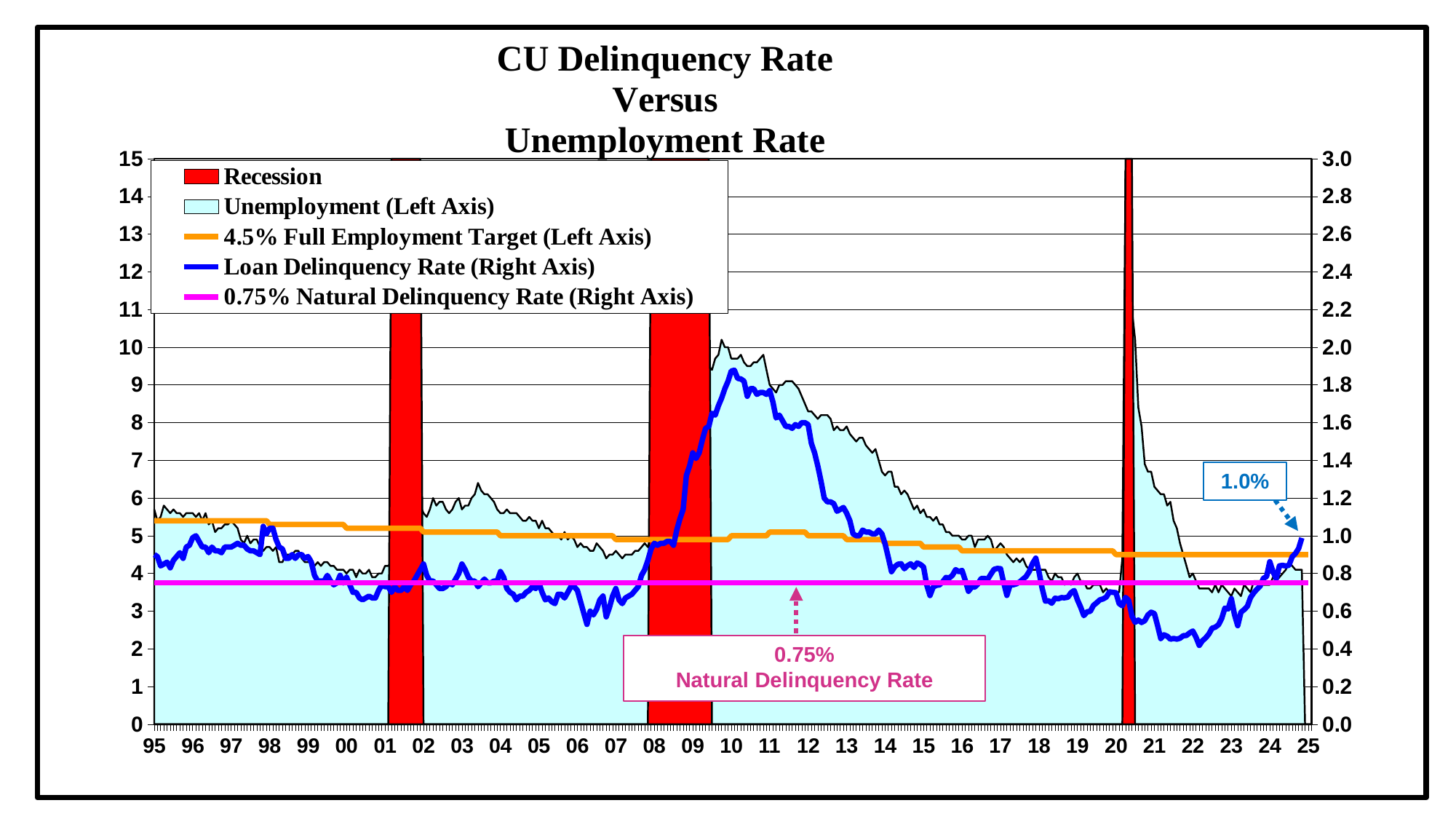
What is the Natural Delinquency Rate shown by the magenta line? 0.75% What value is labelled for the Loan Delinquency Rate at the end of the series in 2025? 1.0% In which year does the unemployment rate reach its highest point? 2020 Does the Loan Delinquency Rate rise or fall from 2022 to 2025? rise Is the unemployment rate in 2010 greater or less than 8 on the left axis? greater Which is larger, the unemployment rate in 2010 or in 2019? 2010 How many series does the legend list? 5 Is the peak unemployment rate in 2020 greater or less than 12 on the left axis? greater What colour are the recession bands? Red What is the title of the chart? CU Delinquency Rate Versus Unemployment Rate Is the Loan Delinquency Rate in 2022 greater or less than 0.6 on the right axis? less How many recession bands are shaded on the chart? 3